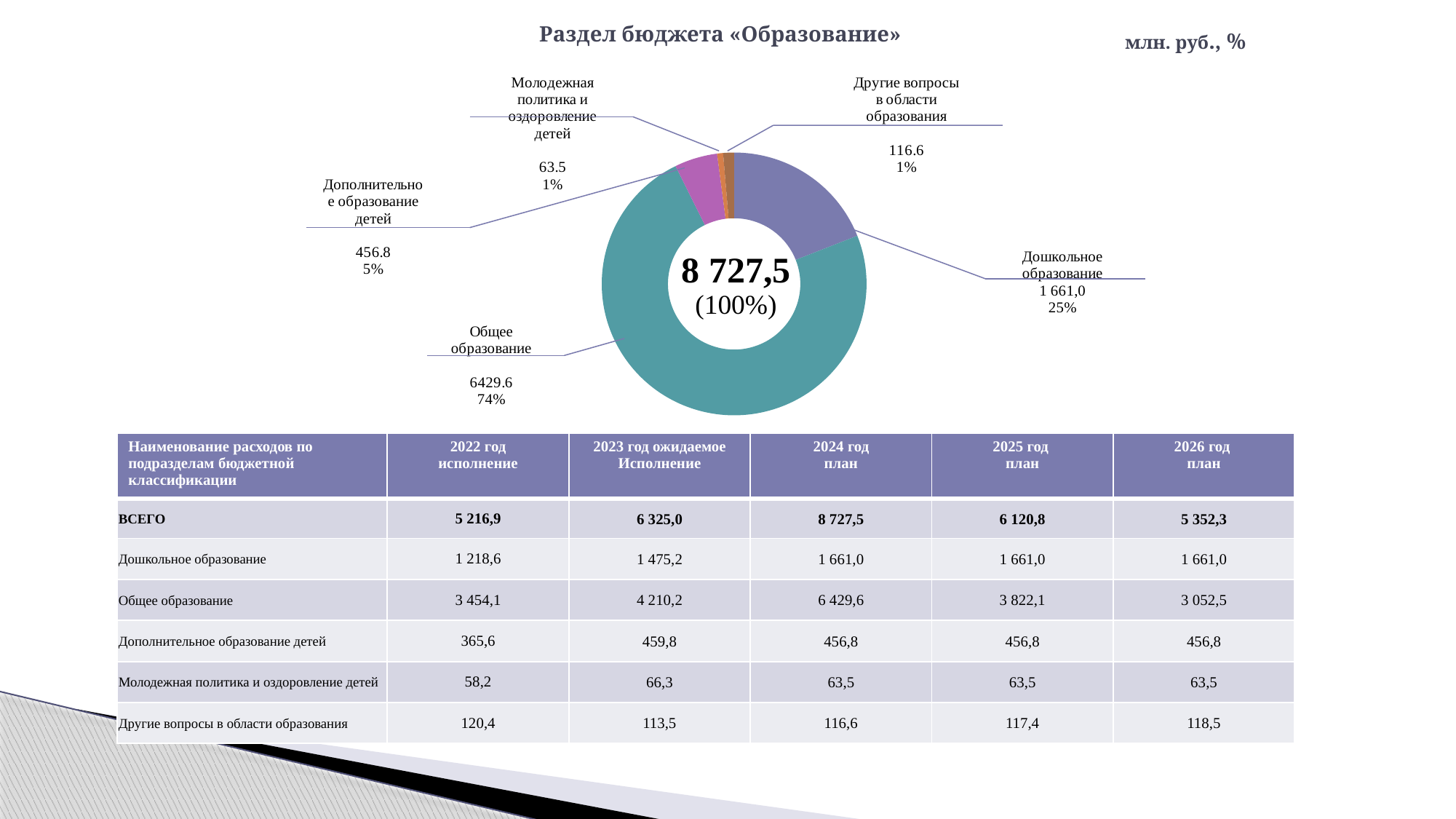
What total value is shown in the centre of the chart? 8 727,5 What is the value shown for Другие вопросы в области образования in the chart? 116.6 How many categories are shown in the chart? 5 What share of the chart does Дошкольное образование represent? 25% Which category has the largest slice in the chart? Общее образование What type of chart is shown on the slide? Pie (donut) chart Which category has the smallest slice in the chart? Молодежная политика и оздоровление детей What is the value shown for Дошкольное образование in the chart? 1 661,0 What is the value shown for Общее образование in the chart? 6429.6 What is the difference between the values for Дополнительное образование детей and Другие вопросы в области образования in the chart? 340.2 What share of the chart does Общее образование represent? 74% What is the value shown for Дополнительное образование детей in the chart? 456.8